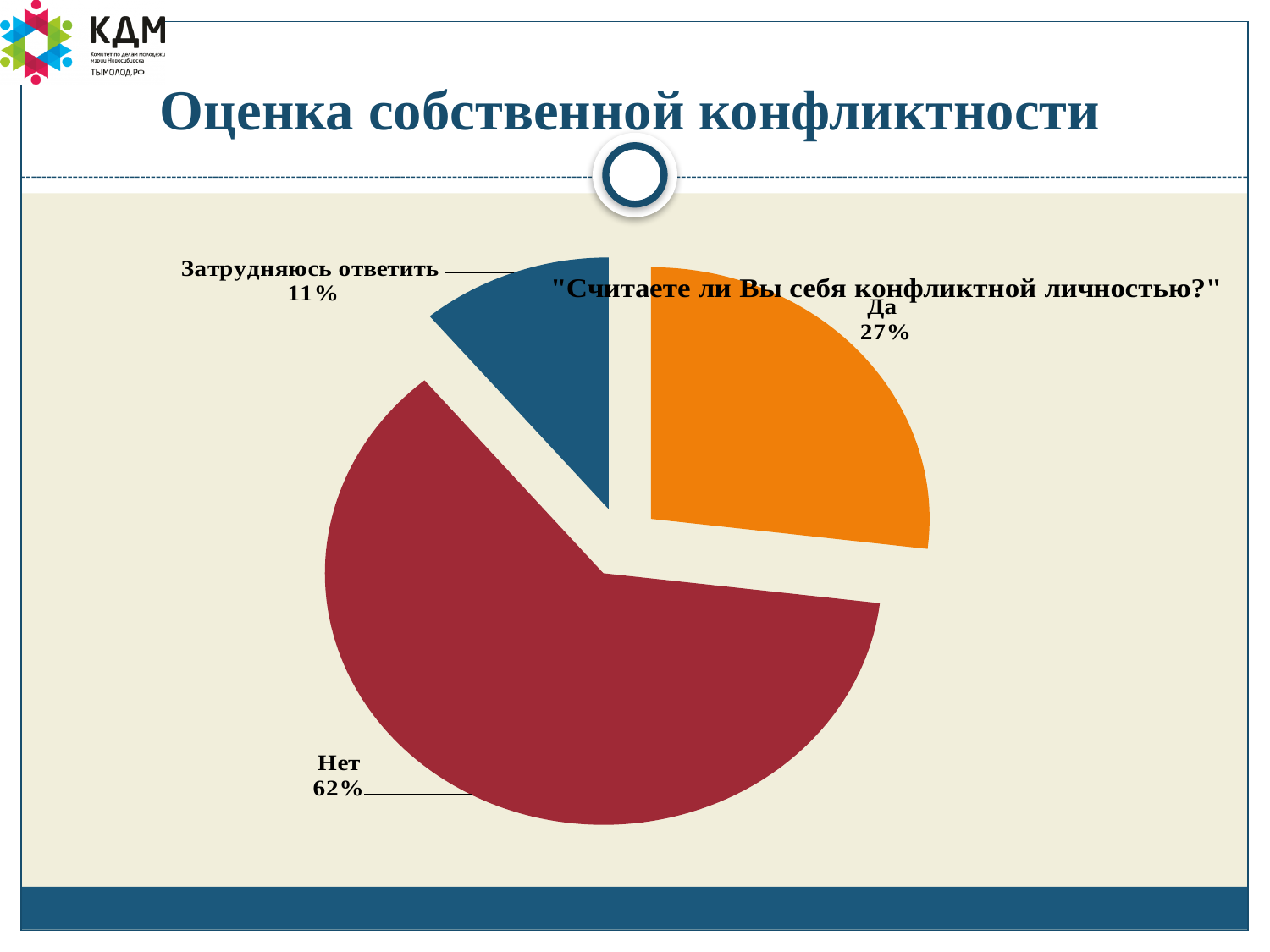
What is the title of the pie chart? "Считаете ли Вы себя конфликтной личностью?" What share of respondents answered "Нет"? 62% How many slices does the pie chart have? 3 What share of respondents answered "Затрудняюсь ответить"? 11% Which answer has the largest slice of the pie? Нет What kind of chart is shown on the slide? pie chart Which is larger, the share for "Да" or the share for "Затрудняюсь ответить"? Да What is the difference in percentage points between "Нет" and "Да"? 35 What colour is the "Нет" slice? red What share of respondents answered "Да"? 27% What is the difference in percentage points between "Да" and "Затрудняюсь ответить"? 16 Which answer has the smallest slice of the pie? Затрудняюсь ответить